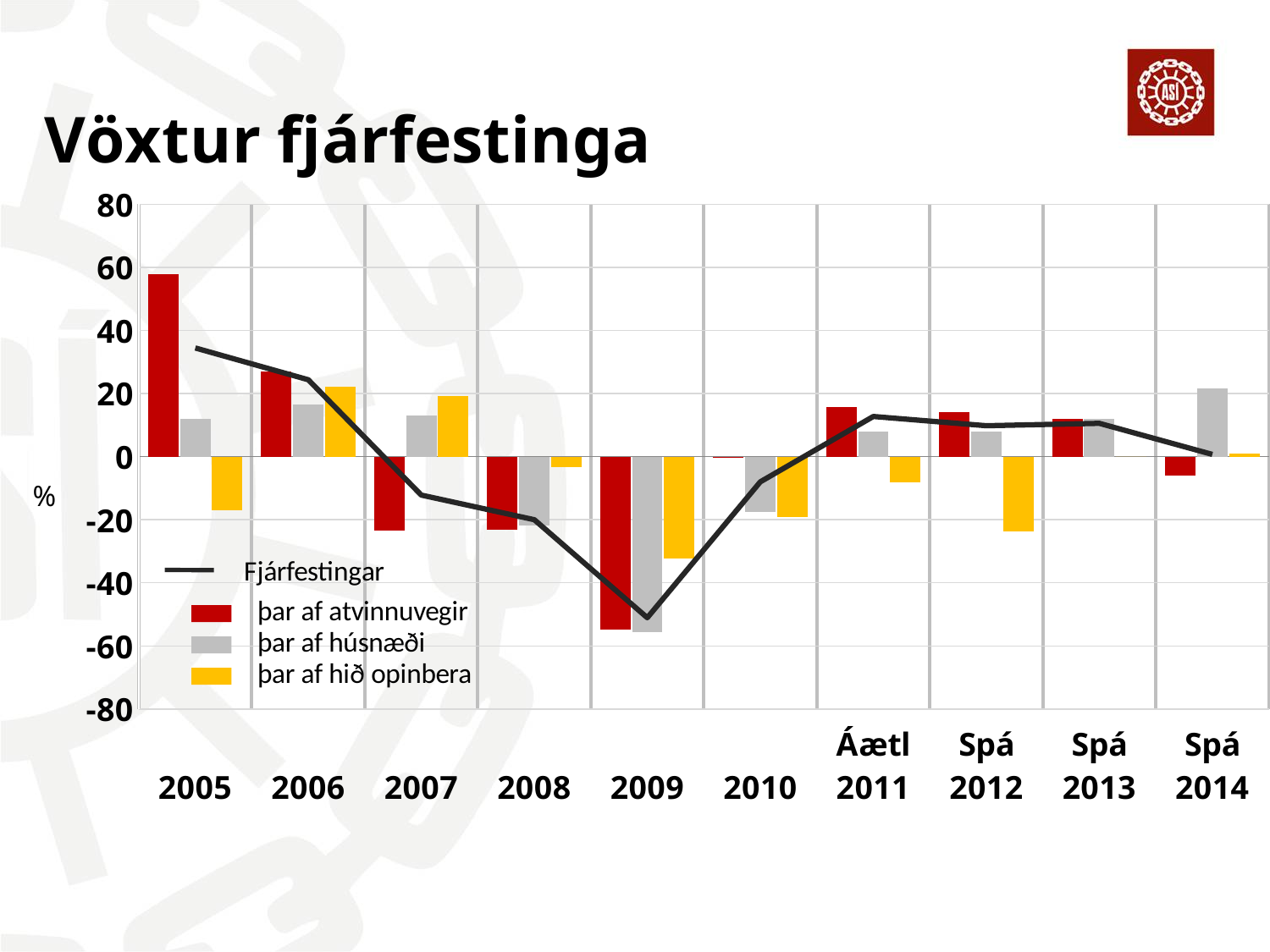
What is the title of the chart? Vöxtur fjárfestinga Is the 'þar af atvinnuvegir' value for 2005 greater or less than 40? greater How many series does the legend list? 4 In which year is the 'þar af hið opinbera' bar lowest? 2009 Does the 'Fjárfestingar' line rise or fall from 2005 to 2009? It falls In which year is the 'þar af atvinnuvegir' bar lowest? 2009 What kind of chart is shown on the slide? A combined bar and line chart Is the 'þar af húsnæði' value for 2009 greater or less than -40? less Which series is drawn as a line rather than bars? Fjárfestingar In which year is the 'þar af atvinnuvegir' bar highest? 2005 Is the 'þar af hið opinbera' value for 2012 greater or less than -20? less How many years (categories) are shown on the x axis? 10